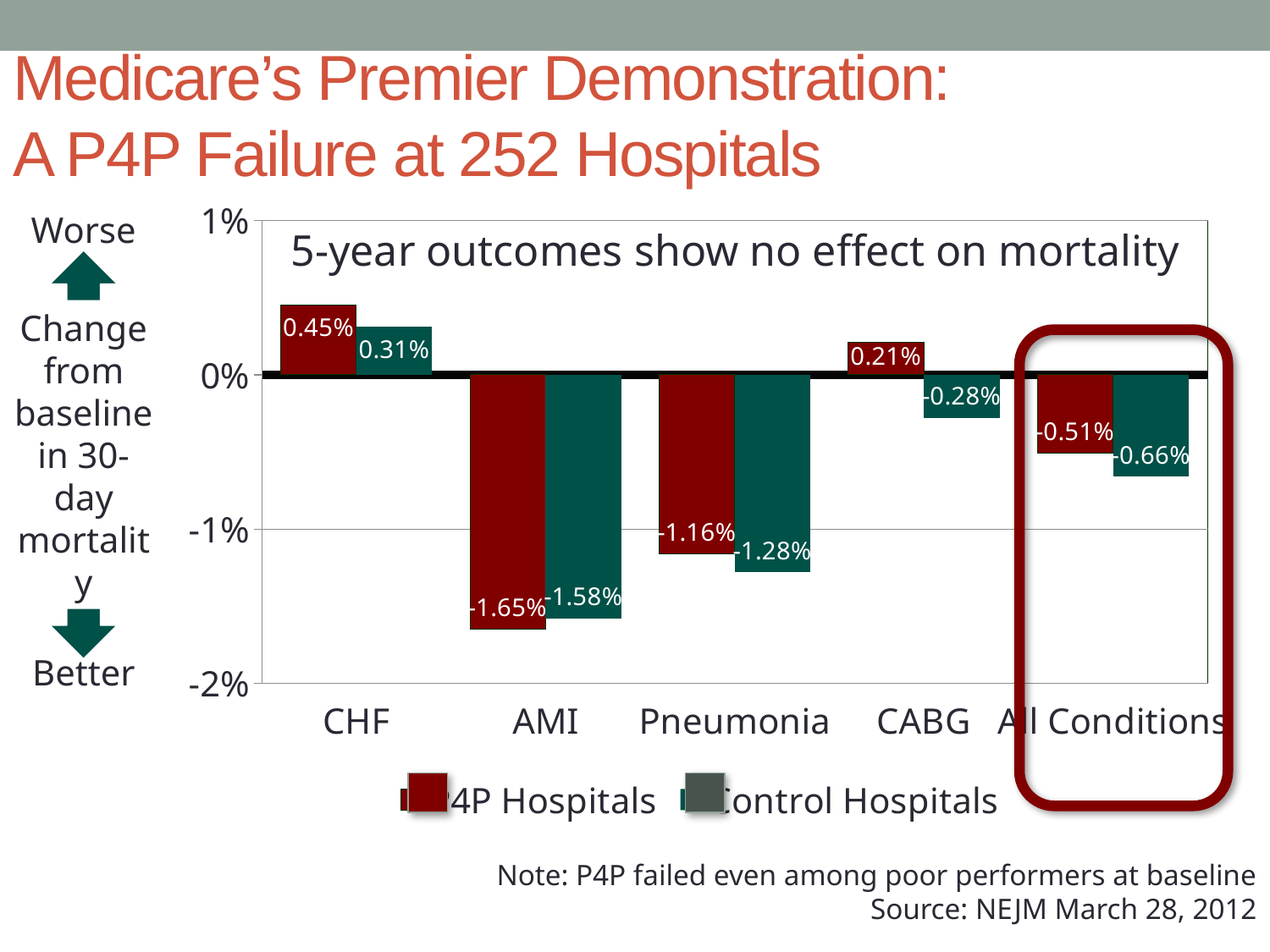
How many categories are shown on the x axis? 5 Which category has the highest value for Control Hospitals? CHF What is the value for P4P Hospitals for CHF? 0.45% What is the value for Control Hospitals for AMI? -1.58% What kind of chart is shown on the slide? Bar chart What is the difference between the P4P Hospitals and Control Hospitals values for CHF? 0.14% For Pneumonia, which is larger, the P4P Hospitals value or the Control Hospitals value? P4P Hospitals How many series does the legend list? 2 What is the value for Control Hospitals for CABG? -0.28% What is the text shown inside the chart area above the bars? 5-year outcomes show no effect on mortality What is the value for P4P Hospitals for All Conditions? -0.51% Which category has the lowest value for P4P Hospitals? AMI